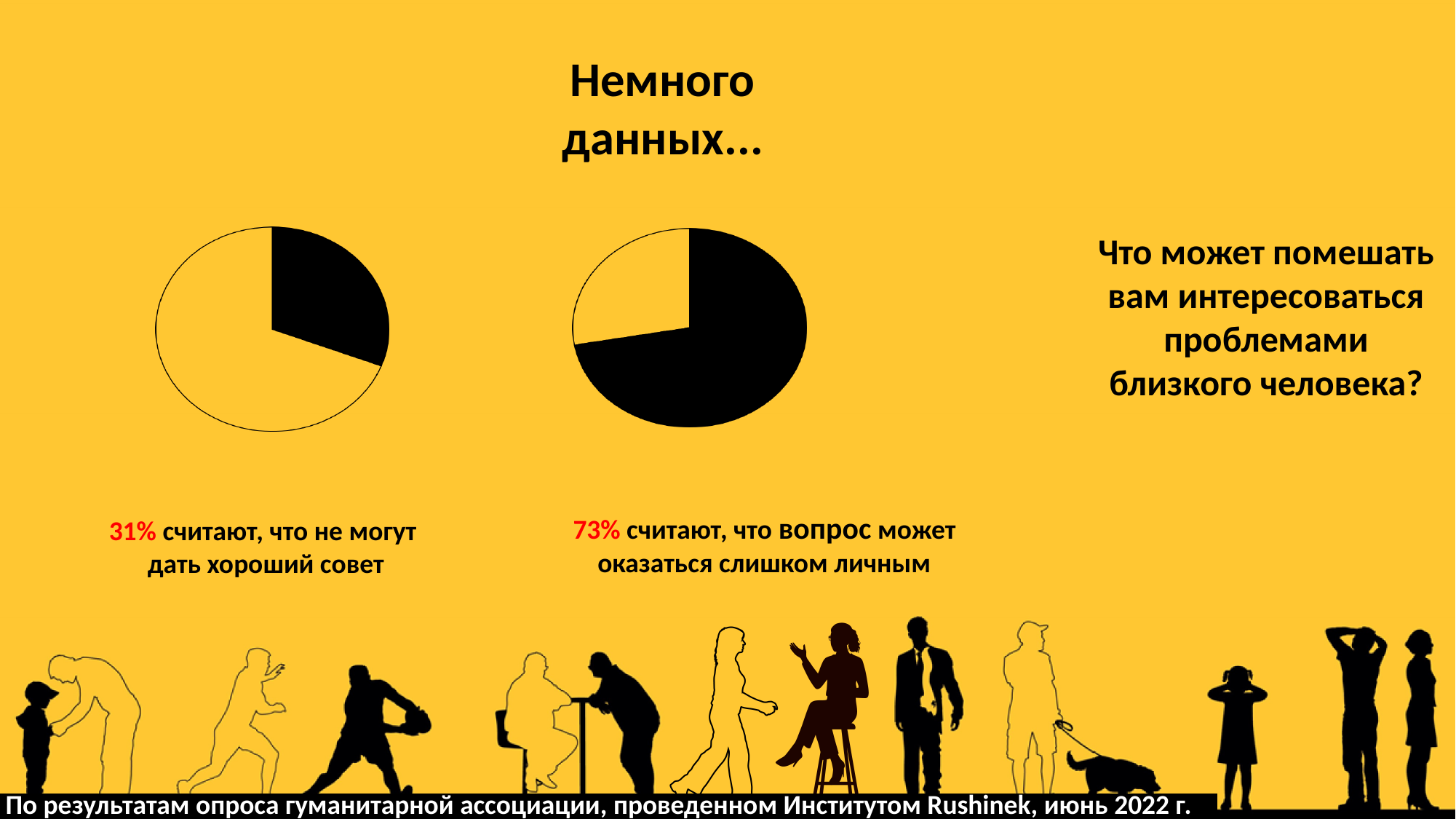
In the left pie chart, what share of respondents think they cannot give good advice? 31% What is the title at the top of the slide above the pie charts? Немного данных... How many pie charts are on the slide? 2 Is the black slice in the left pie chart greater or less than 50%? less What is the difference in percentage points between the 73% share in the right pie chart and the 31% share in the left pie chart? 42 percentage points Which pie chart has the larger black slice, the left one (cannot give good advice) or the right one (question too personal)? The right one (73%) Is the black slice in the right pie chart greater or less than 50%? greater How many slices does the left pie chart have? 2 What colour is used for the 31% and 73% slices in the pie charts? Black In the left pie chart, what share of the pie is the yellow (non-black) slice, given the black slice is 31%? 69% In the right pie chart, what share of respondents think the question may turn out to be too personal? 73% What kind of charts are shown on the slide? Pie charts